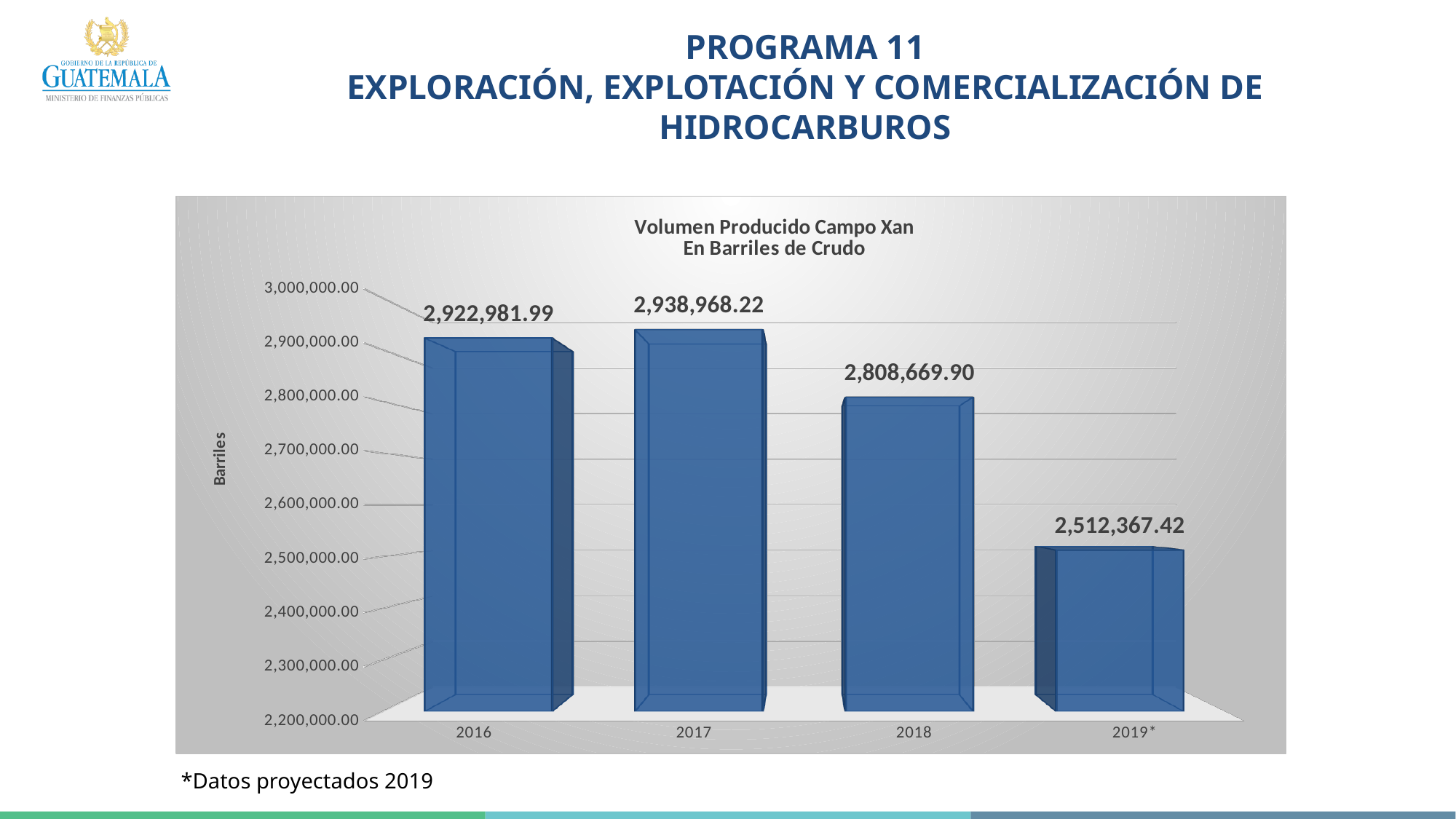
Does the volume produced rise or fall from 2017 to 2019*? Fall Which year has the highest volume produced? 2017 What is the difference between the volume produced in 2017 and in 2016? 15,986.23 What type of chart is shown on the slide? Bar chart How many years are shown on the chart? 4 What is the volume produced in 2018? 2,808,669.90 What is the title of the chart? Volumen Producido Campo Xan En Barriles de Crudo What is the difference between the volume produced in 2018 and the projected volume for 2019*? 296,302.48 Which year has the lowest volume produced? 2019* What is the volume produced in 2017? 2,938,968.22 What is the volume produced in 2016? 2,922,981.99 What is the projected volume produced in 2019*? 2,512,367.42